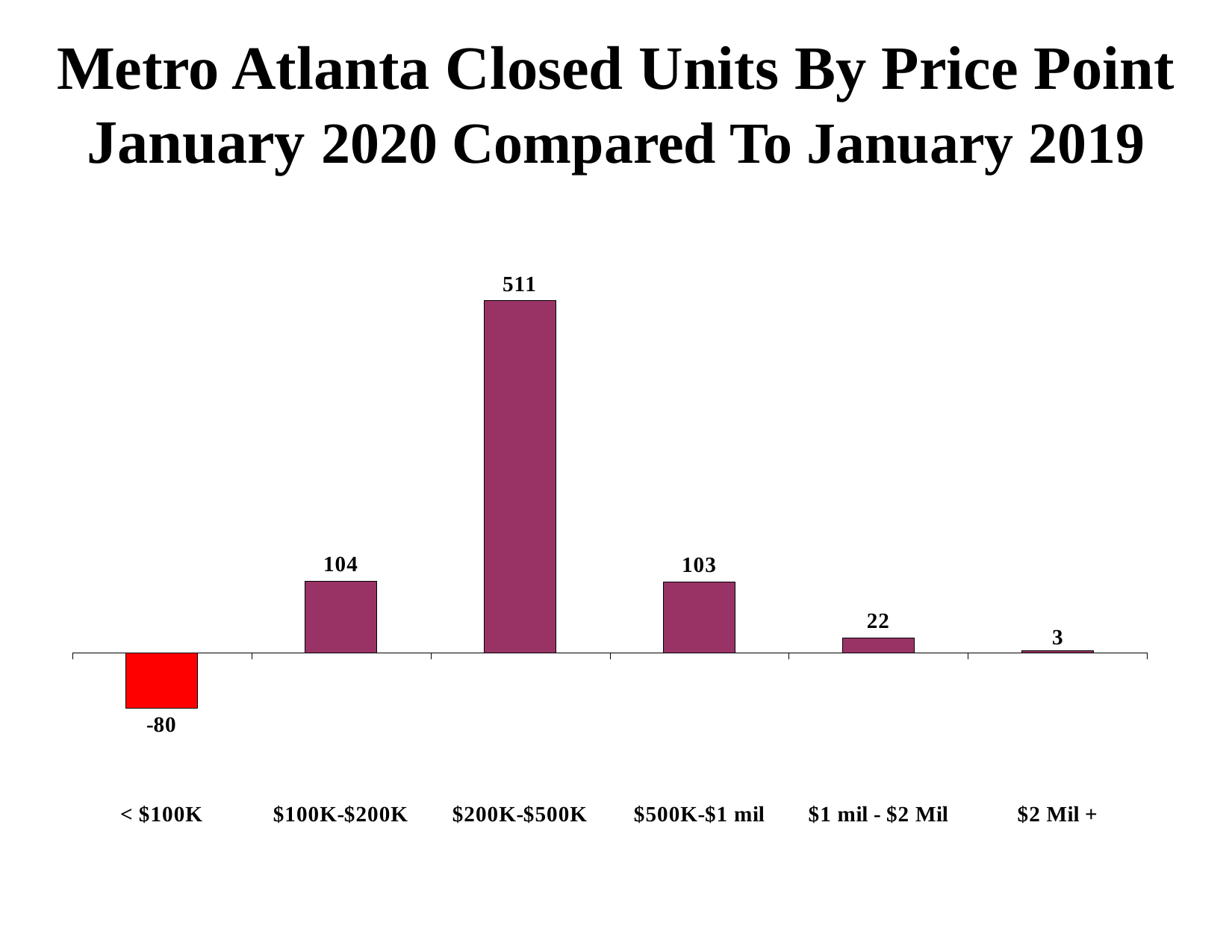
Which is larger, the value for $100K-$200K or the value for $1 mil - $2 Mil? $100K-$200K What is the value for the $1 mil - $2 Mil price point? 22 Which price point has the lowest value? < $100K What is the value for the $200K-$500K price point? 511 How many price point categories are shown on the chart? 6 What is the difference between the values for $100K-$200K and $1 mil - $2 Mil? 82 Which price point has the highest value? $200K-$500K What is the difference between the values for $200K-$500K and $500K-$1 mil? 408 What is the value for the < $100K price point? -80 What kind of chart is shown on the slide? Bar chart Which bar is coloured red rather than purple? < $100K What is the value for the $2 Mil + price point? 3